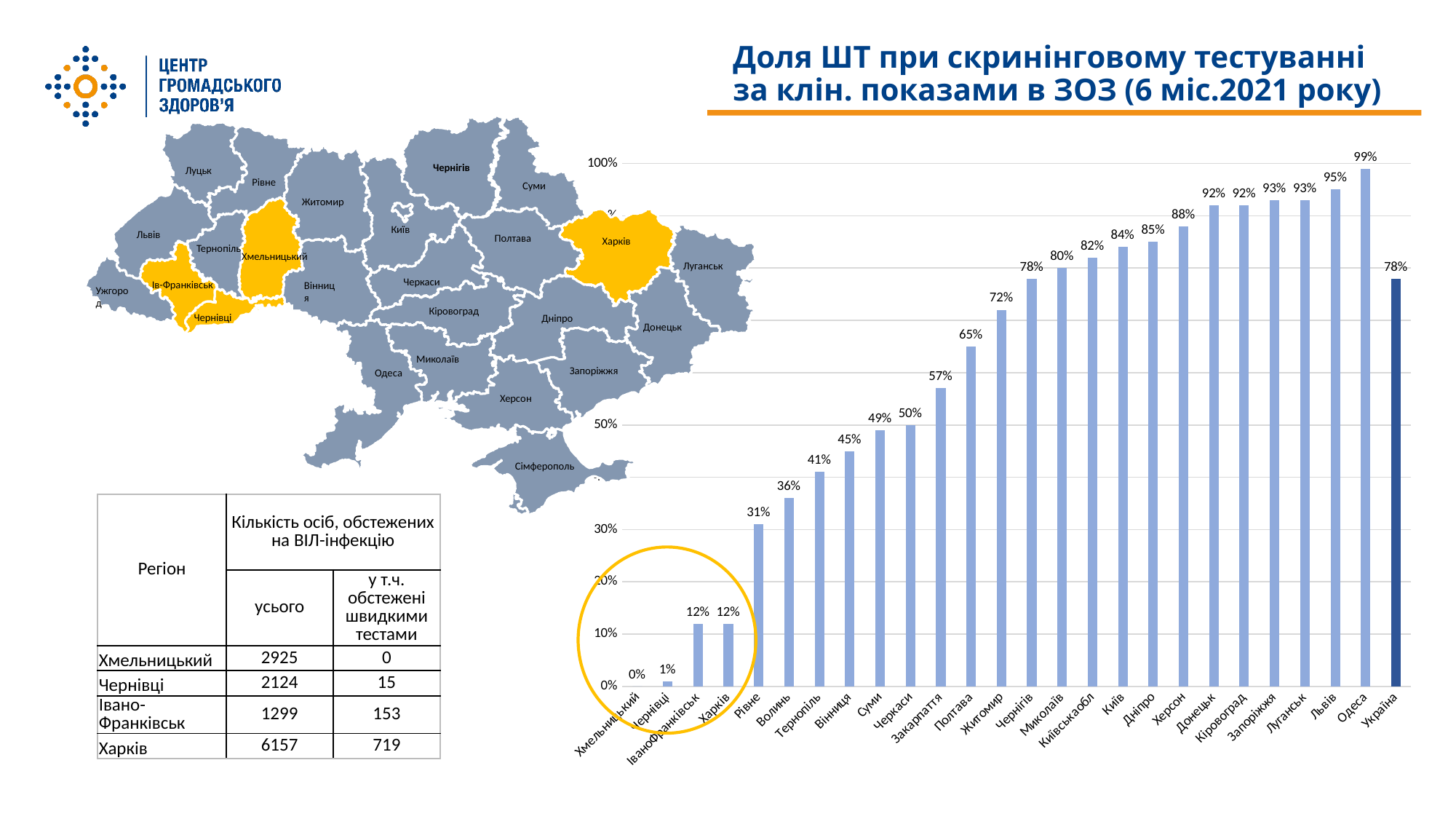
Which region has the highest value in the bar chart? Одеса What is the value for Україна in the bar chart? 78% What is the value for Полтава in the bar chart? 65% What is the value for Чернівці in the bar chart? 1% Do the values in the bar chart generally rise or fall from left to right across the regions? Rise What is the difference between the values for Львів and Рівне in the bar chart? 64% Which region has the lowest value in the bar chart? Хмельницький Which bar in the chart is coloured dark blue, unlike the others? Україна What type of chart is shown on the right of the slide? Bar chart How many categories are shown on the x axis of the bar chart? 26 What is the value for Одеса in the bar chart? 99% Which is larger in the bar chart, the value for Житомир or the value for Закарпаття? Житомир